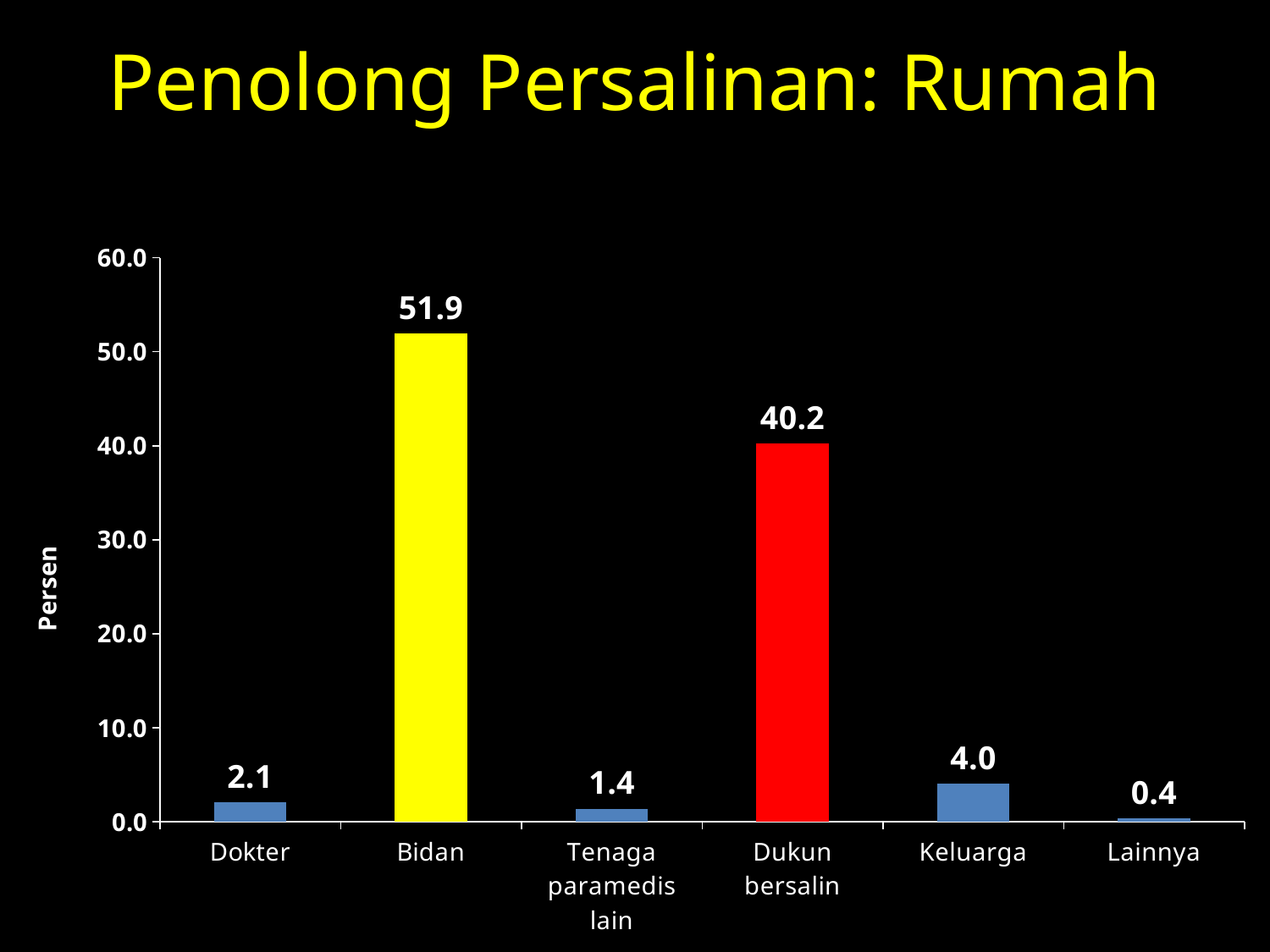
What is the value for Dukun bersalin? 40.2 Which category has the lowest value? Lainnya Which is larger, the value for Dokter or the value for Keluarga? Keluarga Is the value for Dukun bersalin greater or less than 30.0? greater What is the value for Tenaga paramedis lain? 1.4 Which category has the highest value? Bidan What is the title of the slide? Penolong Persalinan: Rumah What is the difference between the values for Bidan and Dukun bersalin? 11.7 How many categories are shown on the x axis? 6 What is the value for Keluarga? 4.0 What kind of chart is shown on the slide? bar chart What is the value for Bidan? 51.9